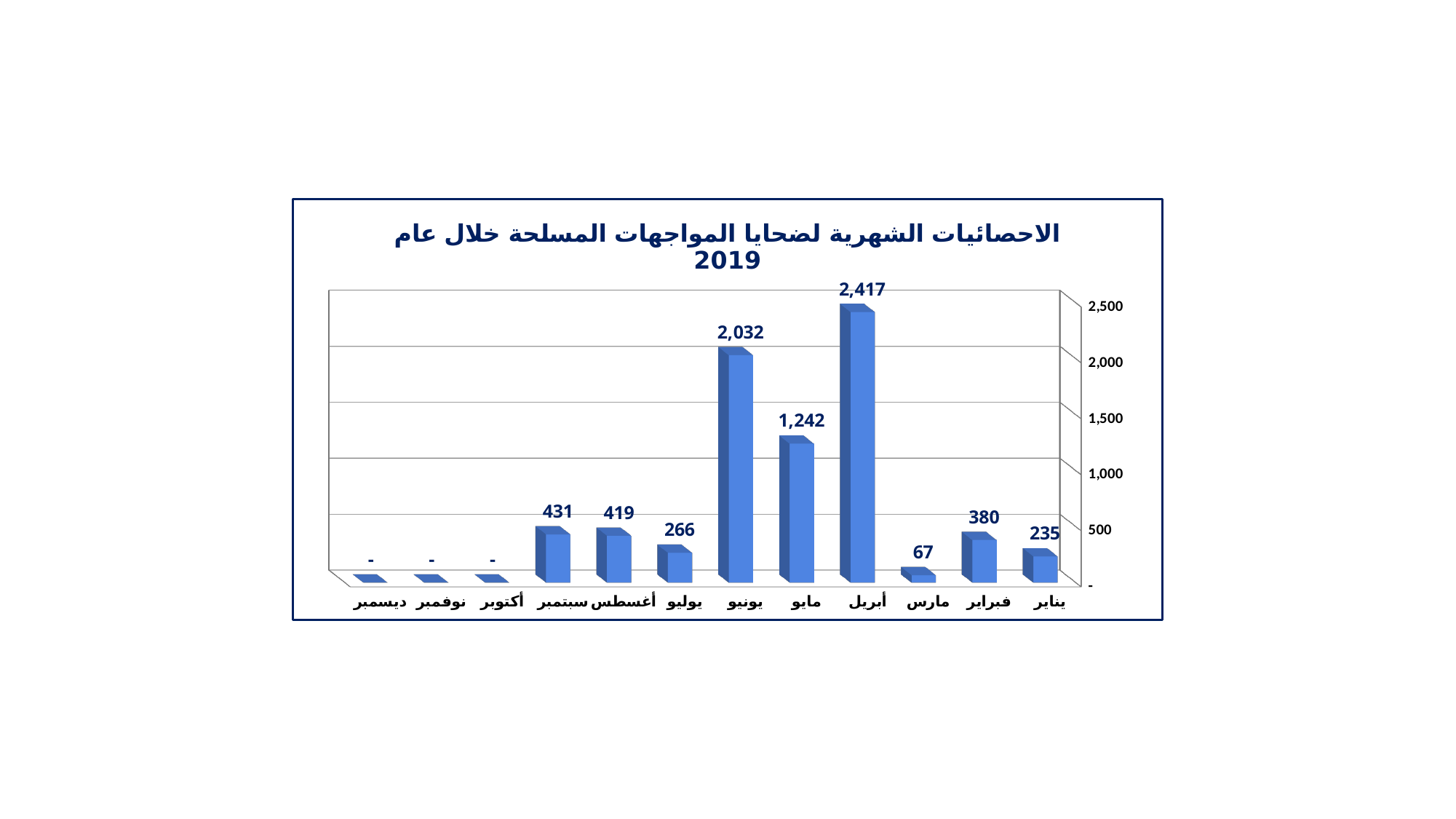
What is the value for أبريل (April)? 2,417 What is the difference between the values for أبريل (April) and يونيو (June)? 385 What kind of chart is this? Bar chart Is the value for مايو (May) greater or less than 1,000? greater How many months are shown on the x axis? 12 Which is larger, the value for فبراير (February) or the value for يناير (January)? فبراير (February) What is the value for مارس (March)? 67 Which month has the highest value? أبريل (April) Among the months with a non-zero value, which has the lowest value? مارس (March) What is the value for مايو (May)? 1,242 What is the value for سبتمبر (September)? 431 Which year does the chart title say the statistics cover? 2019